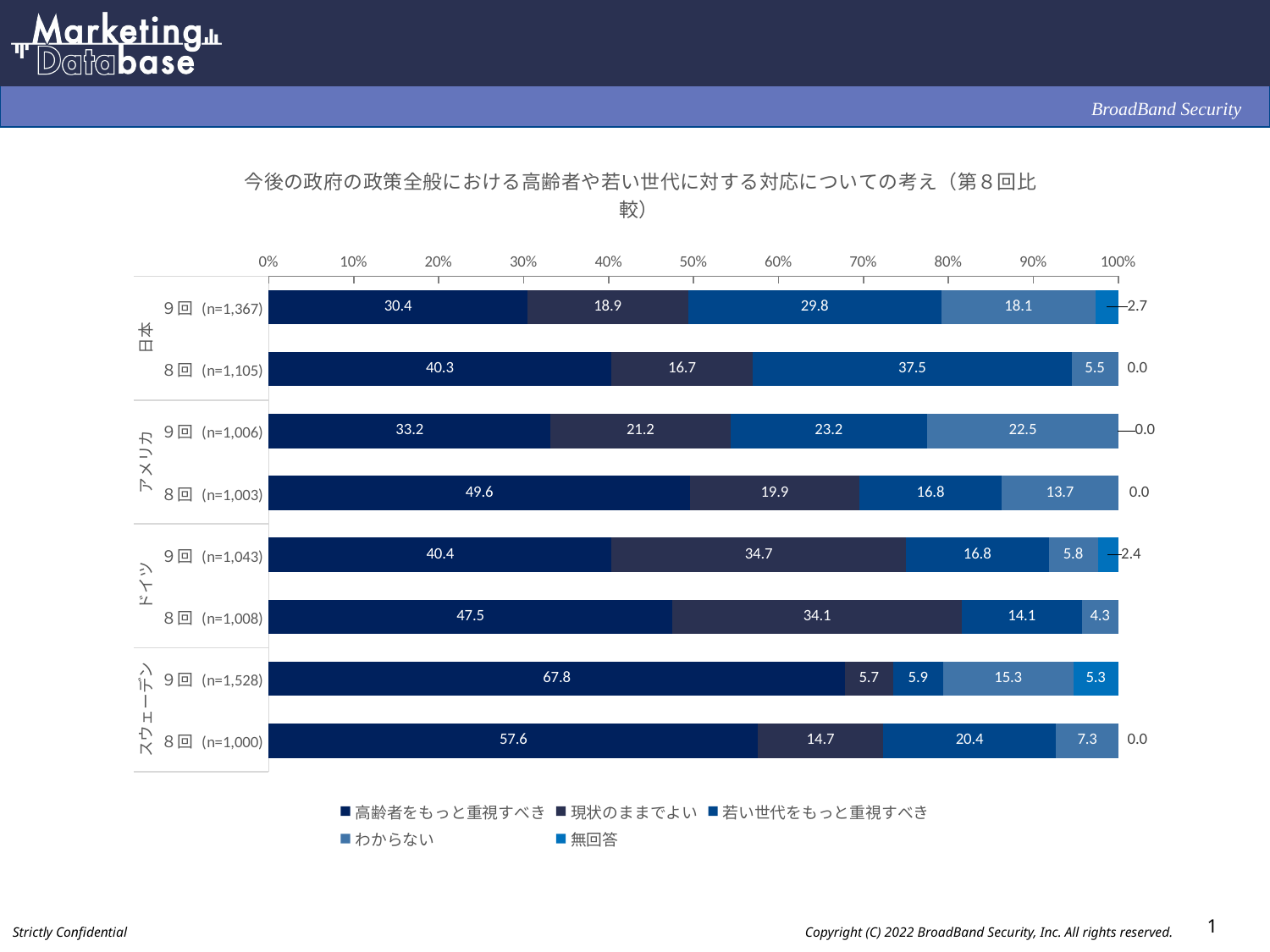
Which is larger: 若い世代をもっと重視すべき for スウェーデン 8回 (n=1,000) or for スウェーデン 9回 (n=1,528)? スウェーデン 8回 (n=1,000) What is the value of 若い世代をもっと重視すべき for 日本 8回 (n=1,105)? 37.5 How many series does the legend list? 5 What is the difference in 高齢者をもっと重視すべき between アメリカ 8回 (n=1,003) and アメリカ 9回 (n=1,006)? 16.4 What is the value of 高齢者をもっと重視すべき for 日本 9回 (n=1,367)? 30.4 What is the value of 現状のままでよい for ドイツ 9回 (n=1,043)? 34.7 How many bars (country-round combinations) are plotted in the chart? 8 What is the sample size (n) shown for ドイツ 8回? n=1,008 Which bar has the lowest value for 高齢者をもっと重視すべき? 日本 9回 (n=1,367) What kind of chart is shown on the slide? Stacked bar chart What is the value of わからない for アメリカ 9回 (n=1,006)? 22.5 Which bar has the highest value for 高齢者をもっと重視すべき? スウェーデン 9回 (n=1,528)